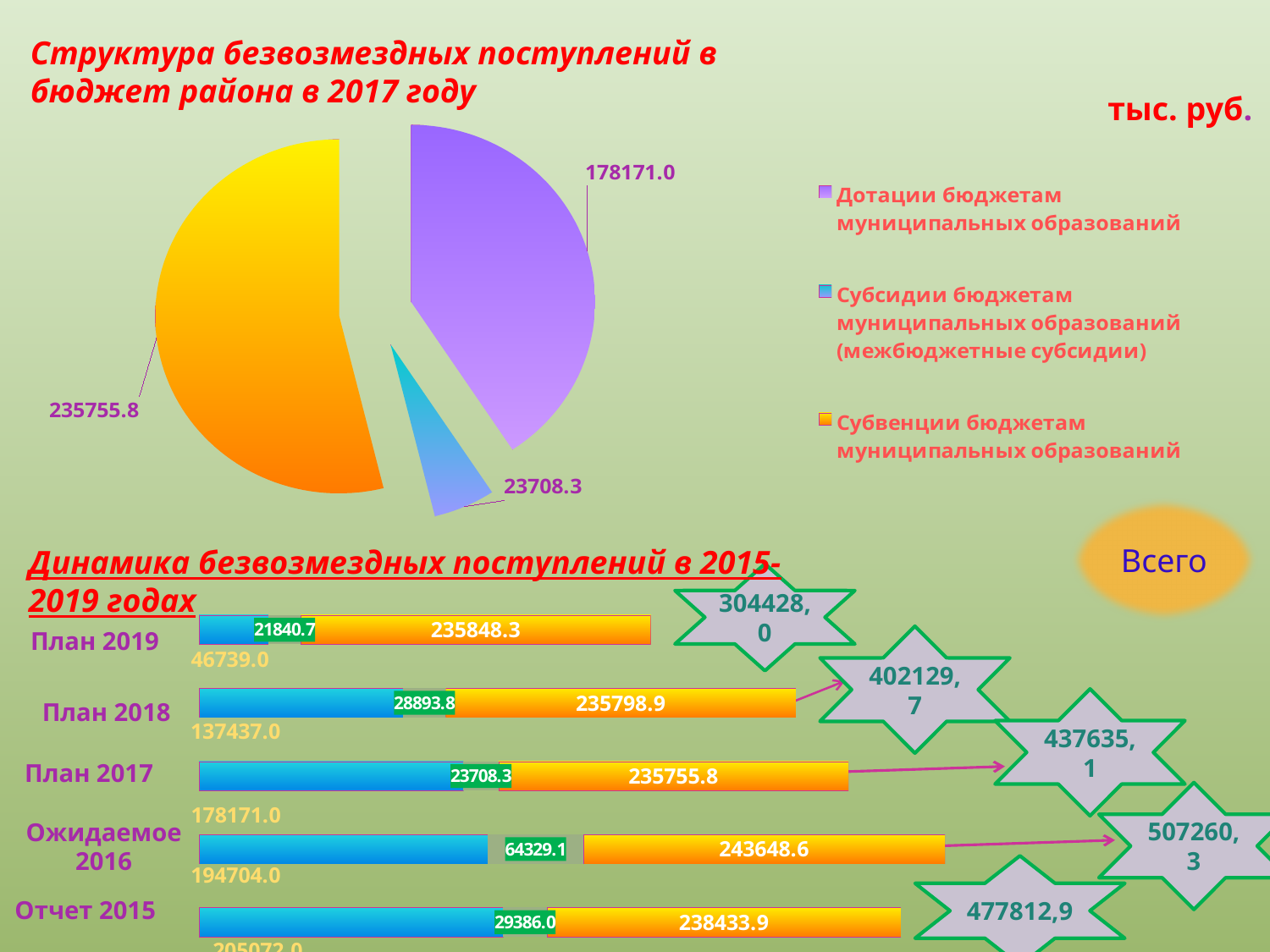
In the pie chart 'Структура безвозмездных поступлений в бюджет района в 2017 году', what is the value for 'Субсидии бюджетам муниципальных образований (межбюджетные субсидии)'? 23708.3 What kind of chart is the top chart, 'Структура безвозмездных поступлений в бюджет района в 2017 году'? pie chart In the pie chart 'Структура безвозмездных поступлений в бюджет района в 2017 году', what is the difference between the 'Субвенции' value and the 'Дотации' value? 57584.8 In the bottom chart 'Динамика безвозмездных поступлений в 2015-2019 годах', what total ('Всего') is shown for 'План 2017'? 437635,1 In the bottom chart 'Динамика безвозмездных поступлений в 2015-2019 годах', what is the value of the orange segment for 'План 2018'? 235798.9 In the pie chart 'Структура безвозмездных поступлений в бюджет района в 2017 году', which category has the largest slice? Субвенции бюджетам муниципальных образований What kind of chart is the bottom chart, 'Динамика безвозмездных поступлений в 2015-2019 годах'? bar chart In the pie chart 'Структура безвозмездных поступлений в бюджет района в 2017 году', how many categories does the legend list? 3 In the bottom chart 'Динамика безвозмездных поступлений в 2015-2019 годах', how many categories (years) are shown? 5 In the bottom chart 'Динамика безвозмездных поступлений в 2015-2019 годах', what is the value of the green segment for 'Ожидаемое 2016'? 64329.1 In the pie chart 'Структура безвозмездных поступлений в бюджет района в 2017 году', which category has the smallest slice? Субсидии бюджетам муниципальных образований (межбюджетные субсидии) In the pie chart 'Структура безвозмездных поступлений в бюджет района в 2017 году', what is the value for 'Дотации бюджетам муниципальных образований'? 178171.0